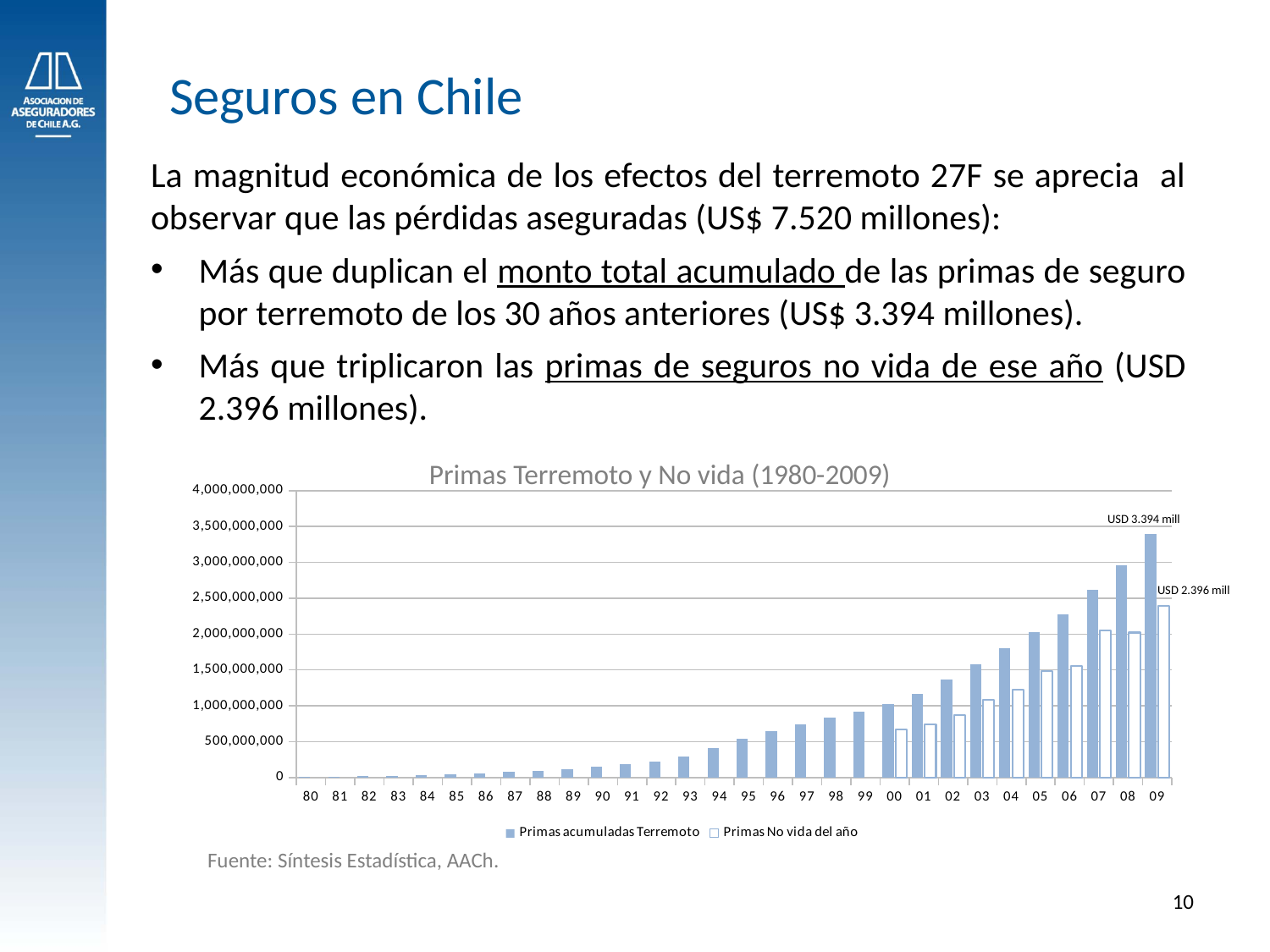
In which year is the Primas acumuladas Terremoto value highest? 09 What value label is printed next to the Primas No vida del año bar for 09? USD 2.396 mill Is the Primas No vida del año value for 00 greater or less than 1,000,000,000? less What kind of chart is shown on the slide? bar chart Do the Primas acumuladas Terremoto values rise or fall from 80 to 09? rise How many series does the chart's legend list? 2 In 09, which series has the larger value, Primas acumuladas Terremoto or Primas No vida del año? Primas acumuladas Terremoto How many years are shown along the x axis of the chart? 30 Is the Primas acumuladas Terremoto value for 08 greater or less than 2,500,000,000? greater What is the title of the chart? Primas Terremoto y No vida (1980-2009) What value label is printed next to the Primas acumuladas Terremoto bar for 09? USD 3.394 mill What are the two series named in the legend? Primas acumuladas Terremoto; Primas No vida del año